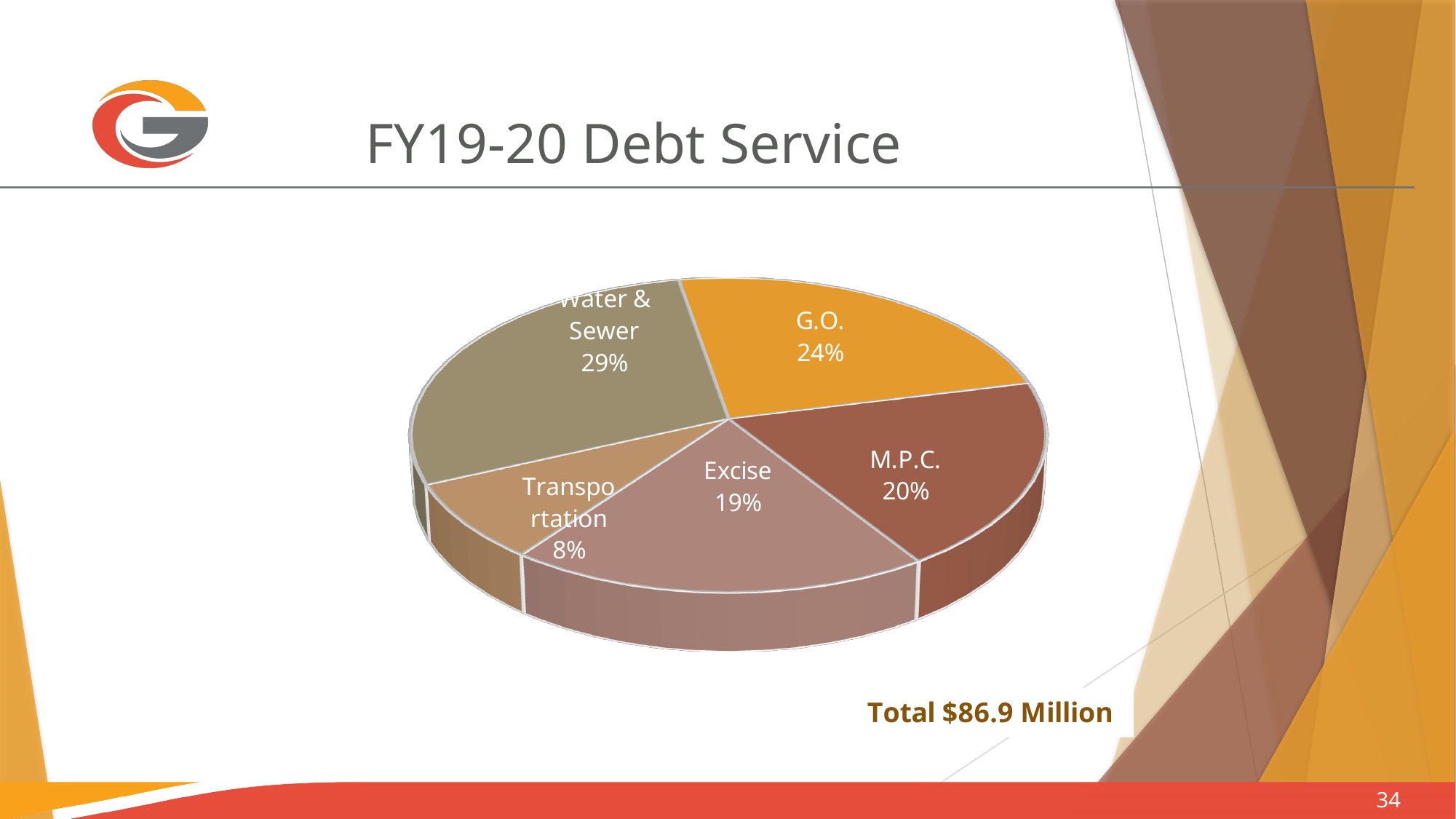
What share of FY19-20 debt service is G.O.? 24% How many categories are shown in the pie chart? 5 What kind of chart is shown on the slide? pie chart What share of FY19-20 debt service is M.P.C.? 20% Which category has the largest share of FY19-20 debt service? Water & Sewer What share of FY19-20 debt service is Water & Sewer? 29% What total debt service amount is stated on the slide? $86.9 Million Which is larger, the G.O. share or the M.P.C. share? G.O. Which category has the smallest share of FY19-20 debt service? Transportation What is the difference in percentage points between the Water & Sewer share and the G.O. share? 5